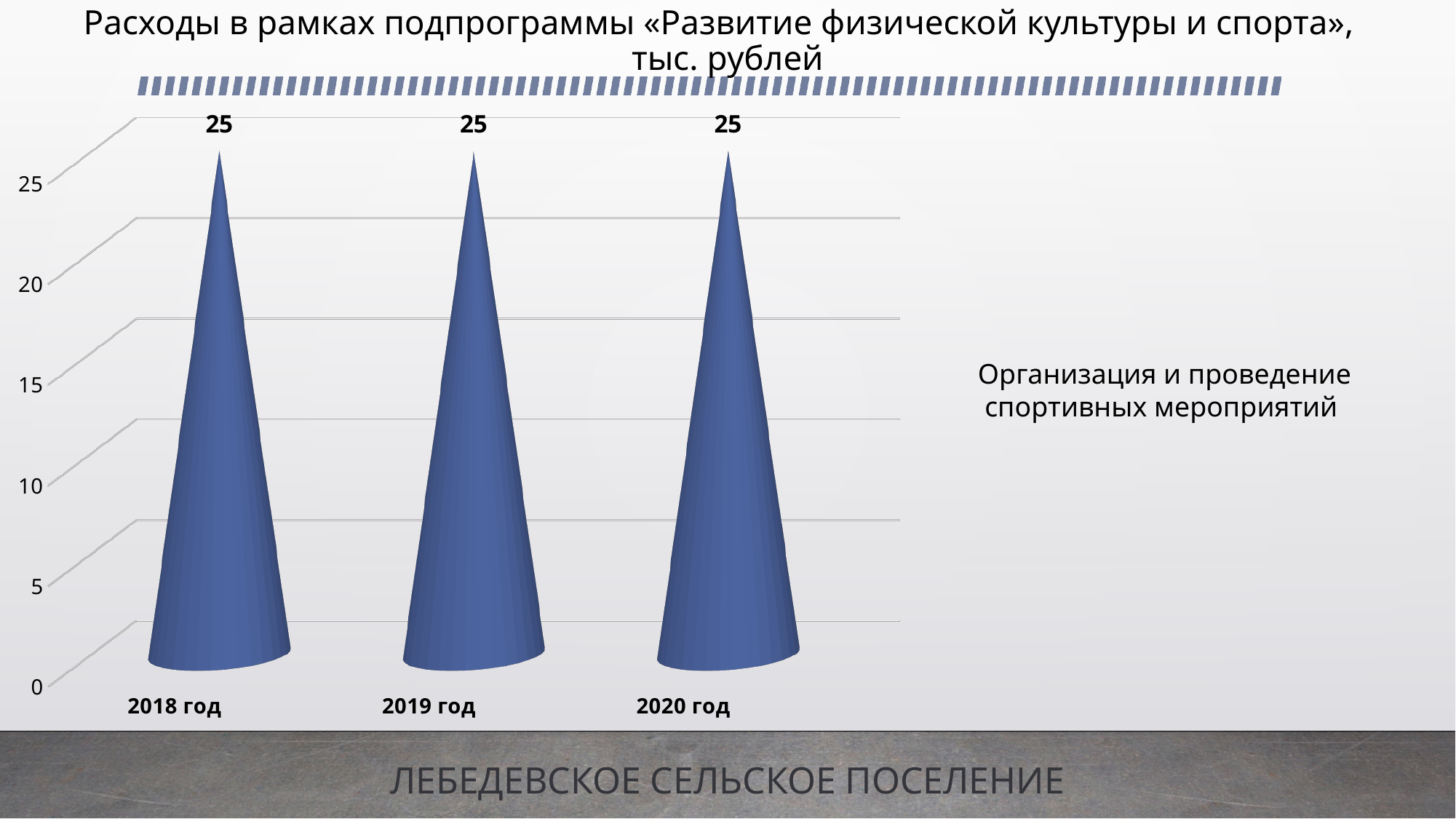
What is the difference between the values for 2018 год and 2020 год? 0 What is the value for 2019 год? 25 What kind of chart is shown on the slide? bar chart What is the value for 2018 год? 25 Is the value for 2019 год greater or less than 20? greater How many categories are shown on the x axis? 3 Do the values rise, fall or stay the same from 2018 год to 2020 год? stay the same What is the value for 2020 год? 25 In what units are the values expressed according to the chart title? тыс. рублей